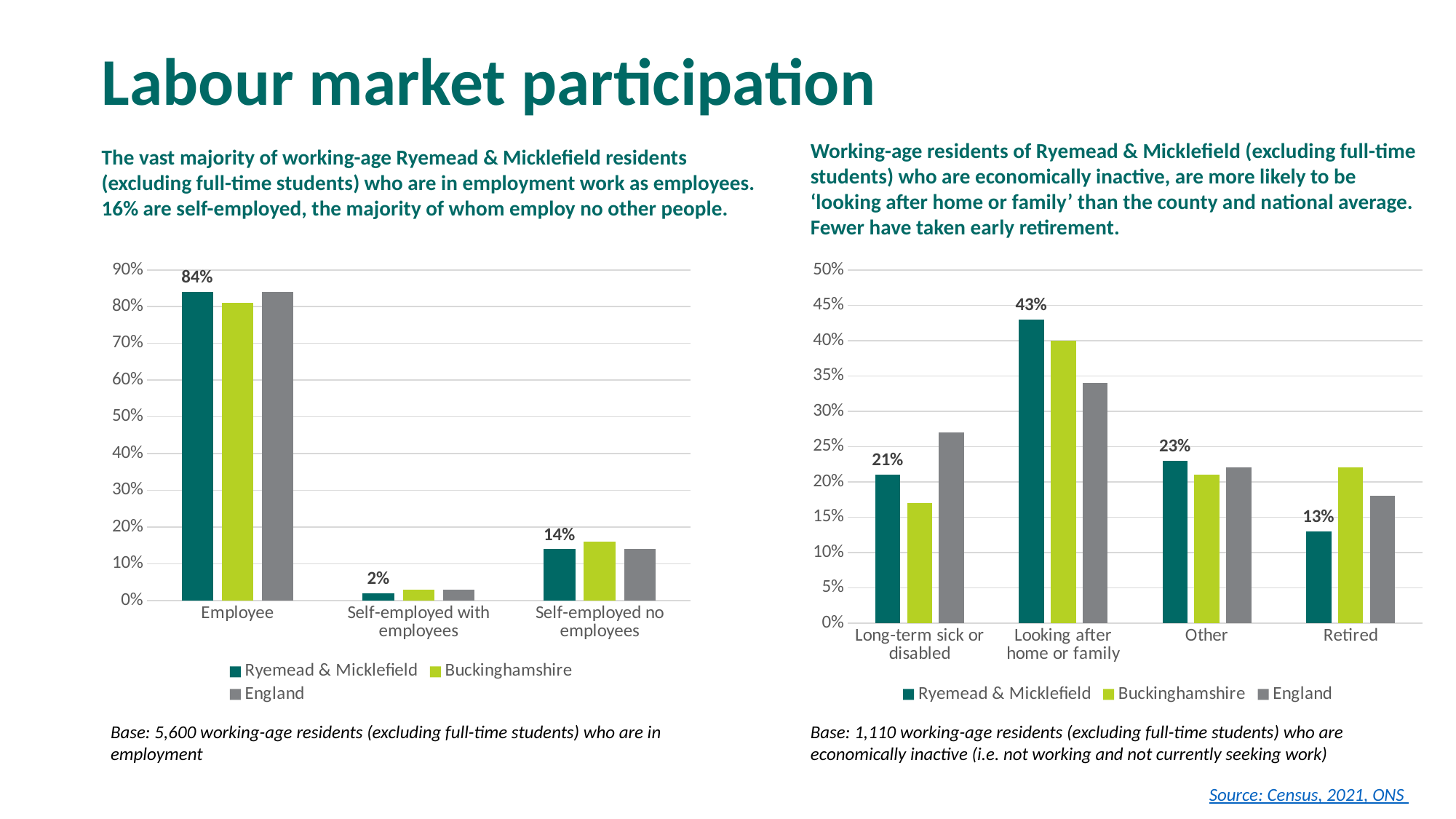
How many categories are shown on the x axis of the right chart? 4 On the right chart, what is the difference between the Ryemead & Micklefield values for 'Looking after home or family' and 'Long-term sick or disabled'? 22 percentage points On the left chart, what percentage of Ryemead & Micklefield residents in employment are employees? 84% How many series does the legend of the left chart list? 3 On the left chart, what is the Ryemead & Micklefield value for 'Self-employed with employees'? 2% On the right chart, what is the Ryemead & Micklefield value for 'Looking after home or family'? 43% On the right chart, what is the Ryemead & Micklefield value for 'Retired'? 13% On the right chart, for 'Retired', which is larger: Buckinghamshire or Ryemead & Micklefield? Buckinghamshire On the right chart, which category has the lowest value for Ryemead & Micklefield? Retired On the right chart, which category has the highest value for Ryemead & Micklefield? Looking after home or family On the right chart, is the England value for 'Long-term sick or disabled' greater or less than 25%? greater On the left chart, what is the Ryemead & Micklefield value for 'Self-employed no employees'? 14%